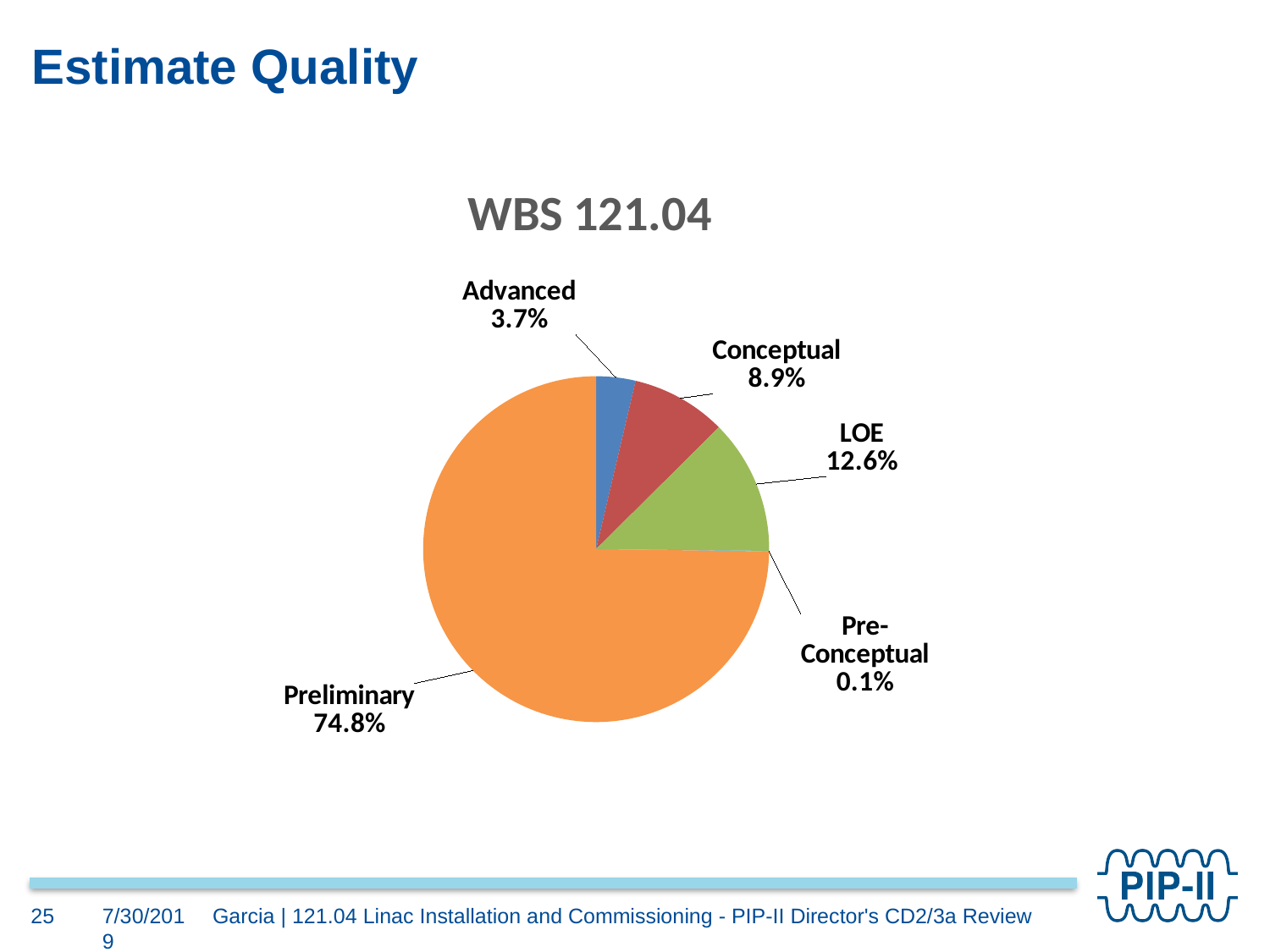
Which category has the smallest share of the pie? Pre-Conceptual What percentage of the pie is Preliminary? 74.8% How many categories are shown in the pie chart? 5 Which is larger, the share for LOE or the share for Conceptual? LOE What percentage of the pie is Advanced? 3.7% Which category has the largest share of the pie? Preliminary What type of chart is shown on the slide? pie chart What percentage of the pie is LOE? 12.6% What percentage of the pie is Conceptual? 8.9% What is the title of the chart? WBS 121.04 What is the difference in percentage points between the LOE share and the Advanced share? 8.9 What percentage of the pie is Pre-Conceptual? 0.1%